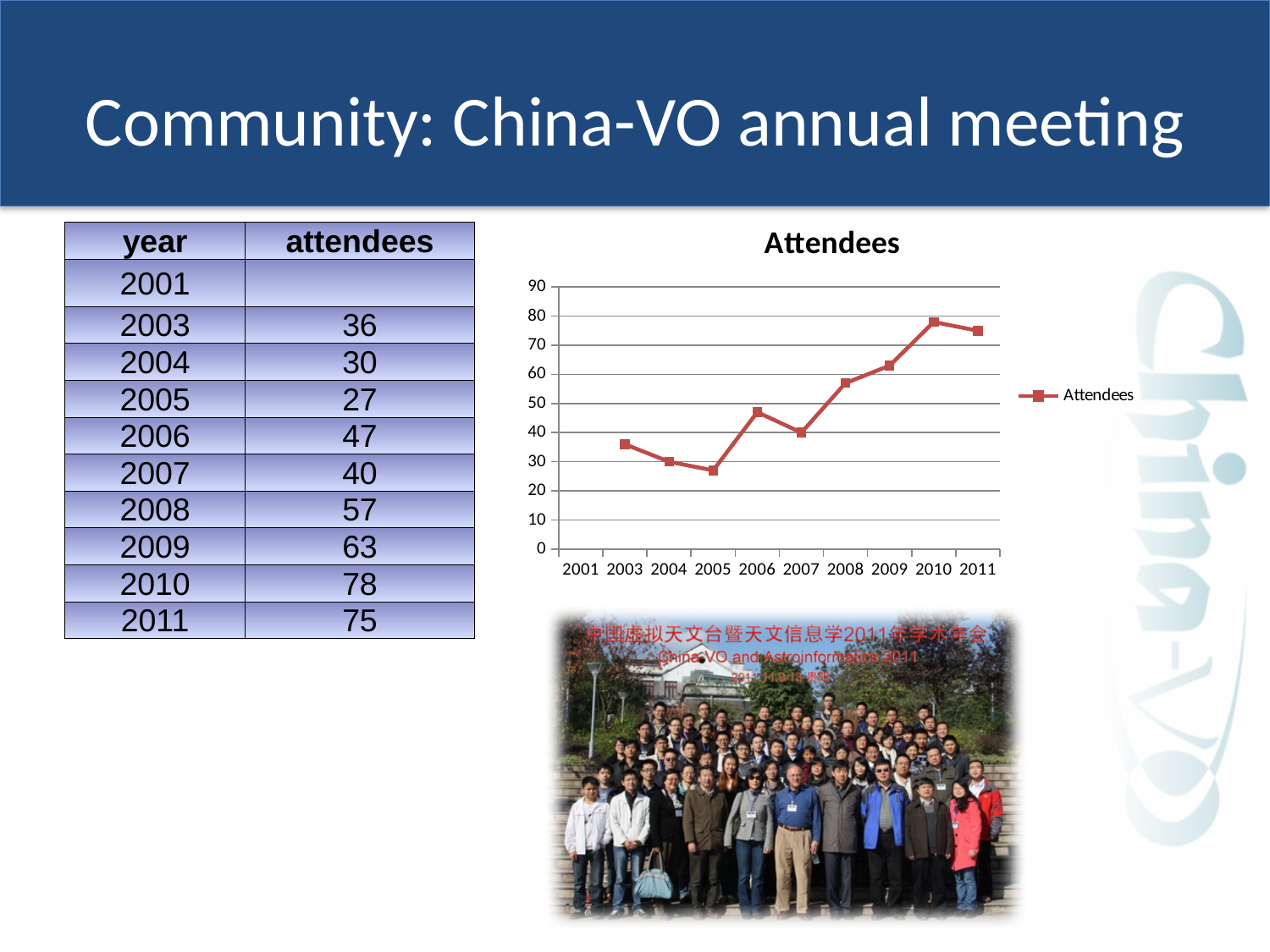
What is the difference in attendees between 2010 and 2011? 3 What is the title of the chart? Attendees Which year has the highest number of attendees? 2010 How many attendees were there in 2003? 36 Do attendee numbers rise or fall from 2005 to 2010? rise How many series does the chart legend list? 1 Which year had more attendees, 2006 or 2007? 2006 How many attendees were there in 2008? 57 Is the value for 2009 greater or less than 60? greater Which year has the lowest number of attendees? 2005 What kind of chart is shown on the slide? line chart How many year labels are shown along the x axis of the chart? 10